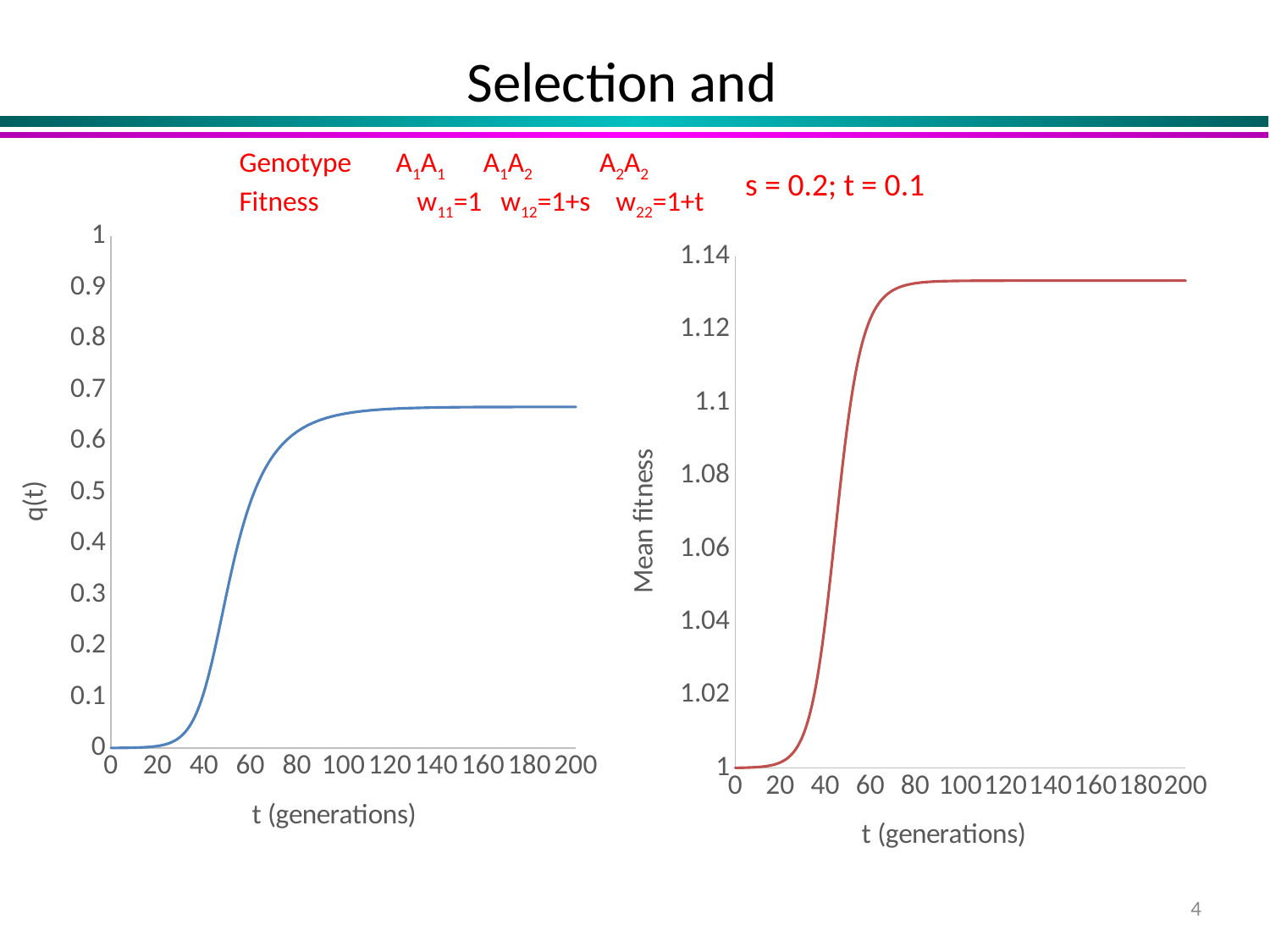
In the right chart (Mean fitness), is the value at t = 20 greater or less than 1.02? less What is the y axis label of the right chart? Mean fitness In the right chart (Mean fitness), does the line rise or fall as t increases from 0 to 200? rise In the left chart (q(t)), does the line rise or fall as t increases from 0 to 200? rise What kind of chart is the right chart with y axis Mean fitness? line chart In the left chart (q(t)), is the value at t = 100 greater or less than 0.6? greater What is the x axis label of the left chart (q(t))? t (generations) In the right chart (Mean fitness), is the value at t = 60 greater or less than 1.1? greater What kind of chart is the left chart with y axis q(t)? line chart